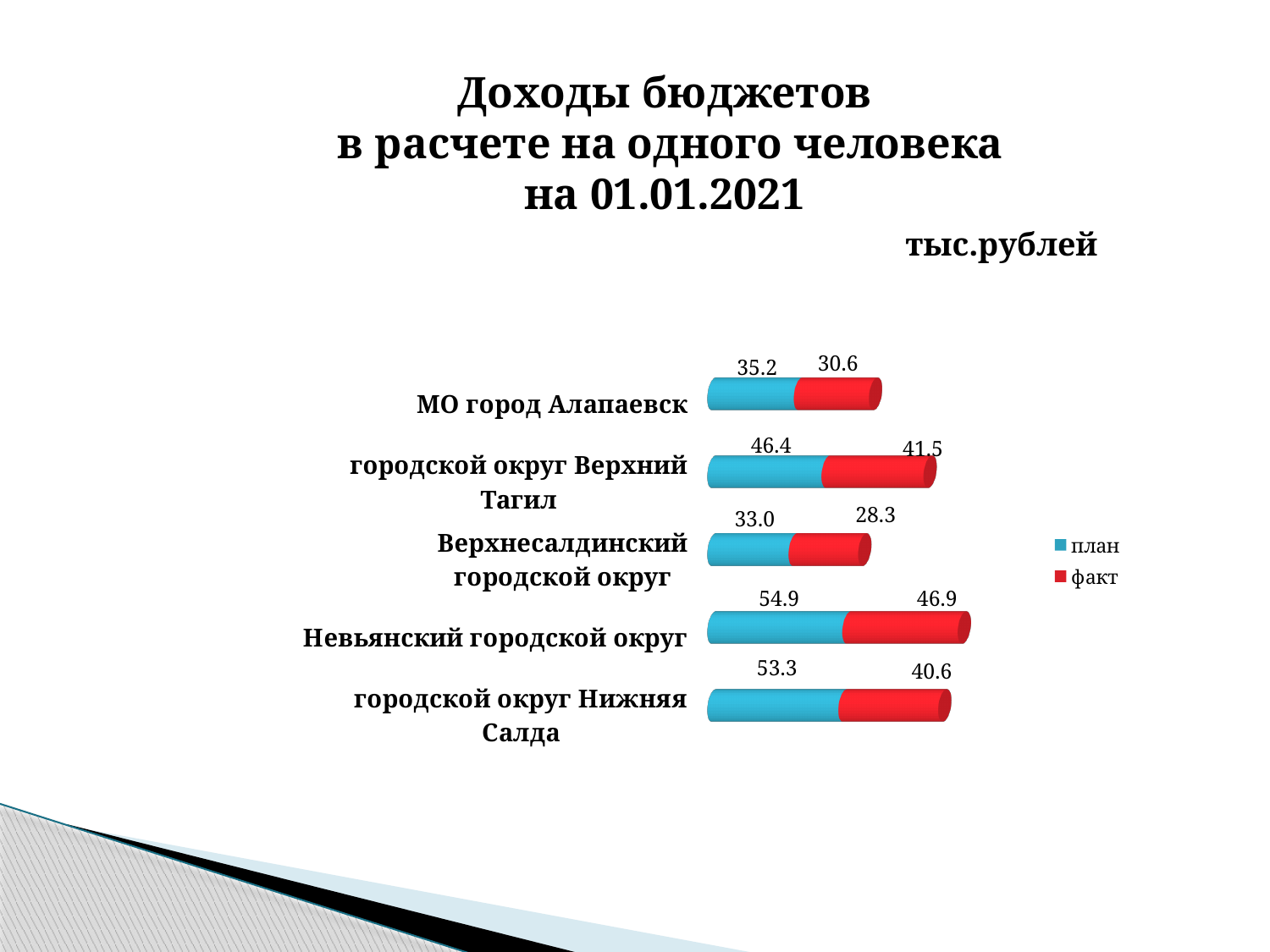
Which category has the lowest факт value? Верхнесалдинский городской округ What is the difference between план and факт for городской округ Нижняя Салда? 12.7 What is the total of the stacked bar for Верхнесалдинский городской округ? 61.3 What kind of chart is shown on the slide? Stacked bar chart Which is larger: the план value for городской округ Верхний Тагил or the план value for МО город Алапаевск? городской округ Верхний Тагил Which category has the highest план value? Невьянский городской округ What is the факт value for МО город Алапаевск? 30.6 What is the план value for Невьянский городской округ? 54.9 What is the difference between план and факт for Невьянский городской округ? 8.0 How many series does the legend list? 2 What is the факт value for городской округ Нижняя Салда? 40.6 How many categories are shown in the chart? 5